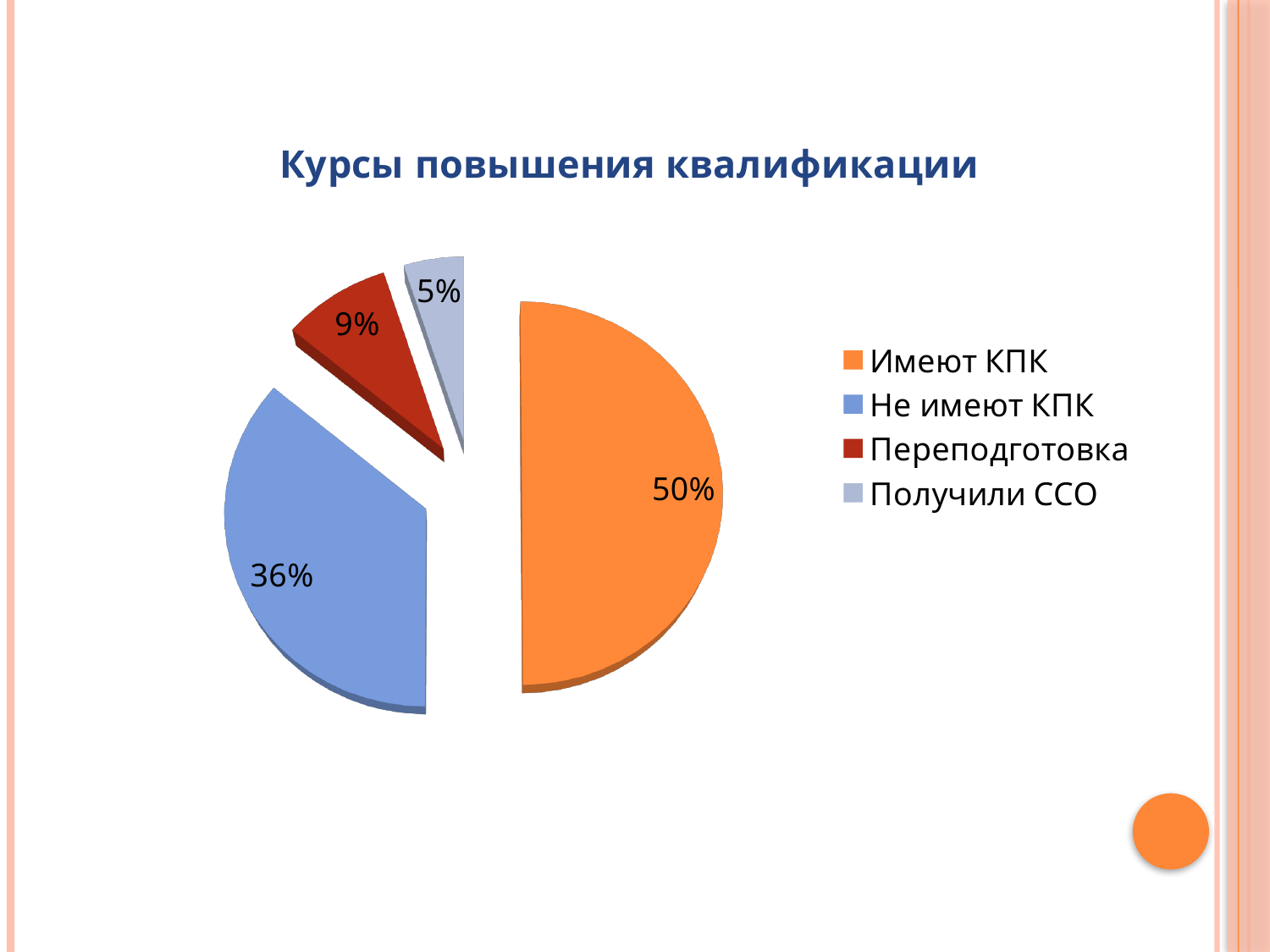
How many categories does the pie chart show? 4 What is the title of the chart? Курсы повышения квалификации What type of chart is shown on the slide? pie chart What share of the pie does "Переподготовка" take? 9% Which category has the smallest slice of the pie? Получили ССО What colour is the slice for "Не имеют КПК"? blue What share of the pie does "Имеют КПК" take? 50% What share of the pie does "Получили ССО" take? 5% Which is larger, the slice for "Переподготовка" or the slice for "Получили ССО"? Переподготовка What is the difference in percentage points between "Имеют КПК" and "Не имеют КПК"? 14% Which category has the largest slice of the pie? Имеют КПК